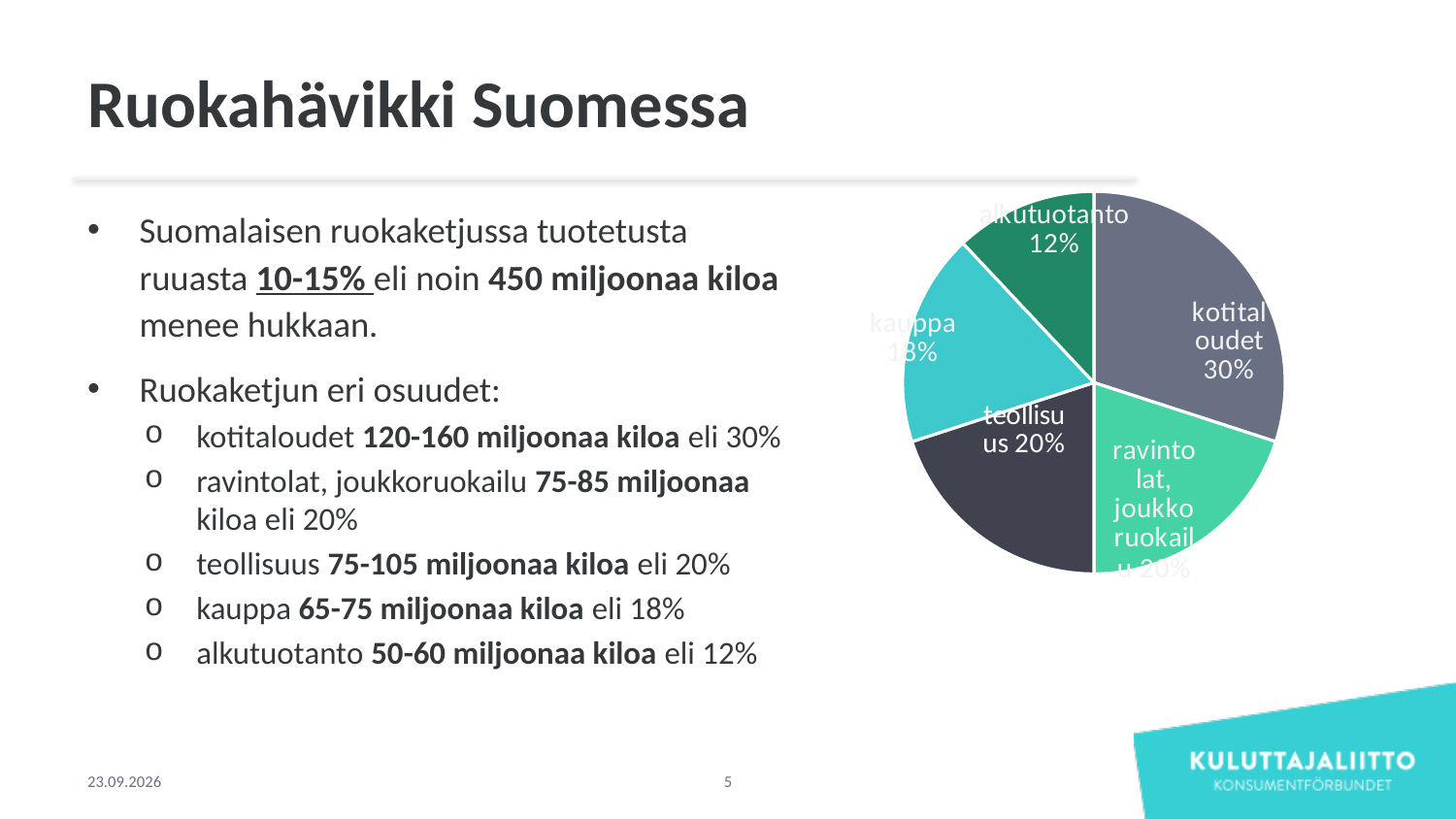
Which slice of the pie chart is the smallest? alkutuotanto What is the difference in percentage points between the kauppa slice and the alkutuotanto slice? 6 What share of the pie does kauppa have? 18% What share of the pie does kotitaloudet have? 30% How many slices does the pie chart have? 5 What share of the pie does teollisuus have? 20% Is the share for kotitaloudet greater or less than 25%? greater What kind of chart is shown on the slide? pie chart Which slice of the pie chart is the largest? kotitaloudet What is the difference in percentage points between the kotitaloudet slice and the alkutuotanto slice? 18 Which is larger in the pie chart, kauppa or alkutuotanto? kauppa